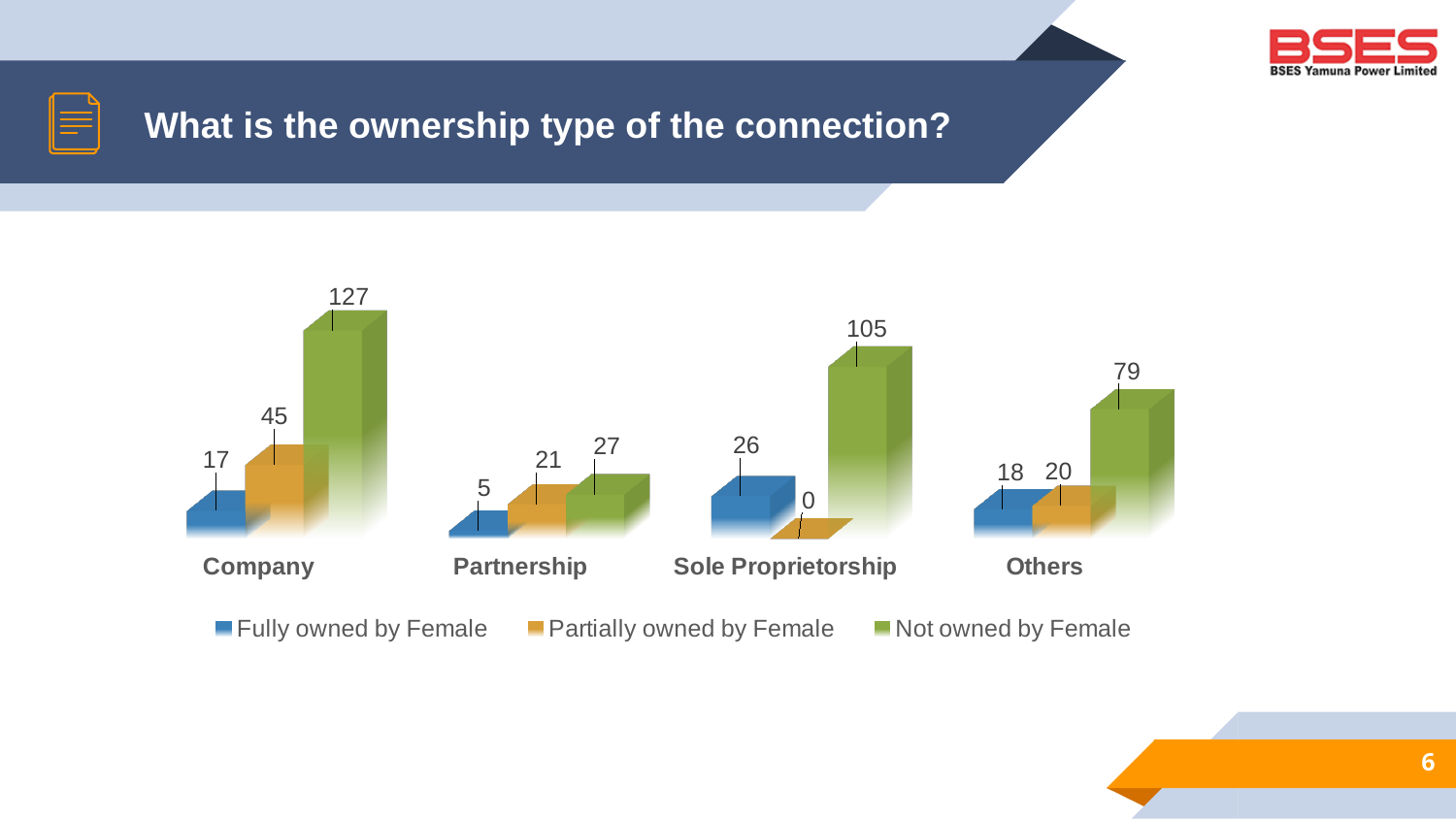
Which category has the lowest value for Fully owned by Female? Partnership What is the difference between Not owned by Female and Fully owned by Female in the Sole Proprietorship category? 79 What is the value for Not owned by Female in the Company category? 127 What kind of chart is shown on the slide? Bar chart Which category has the highest value for Not owned by Female? Company What is the value for Fully owned by Female in the Partnership category? 5 What is the value for Partially owned by Female in the Others category? 20 How many ownership categories are shown on the x axis? 4 How many series does the legend list? 3 Which is larger: Partially owned by Female for Company or Partially owned by Female for Partnership? Company What is the value for Partially owned by Female in the Sole Proprietorship category? 0 Which colour represents Not owned by Female in the legend? Green